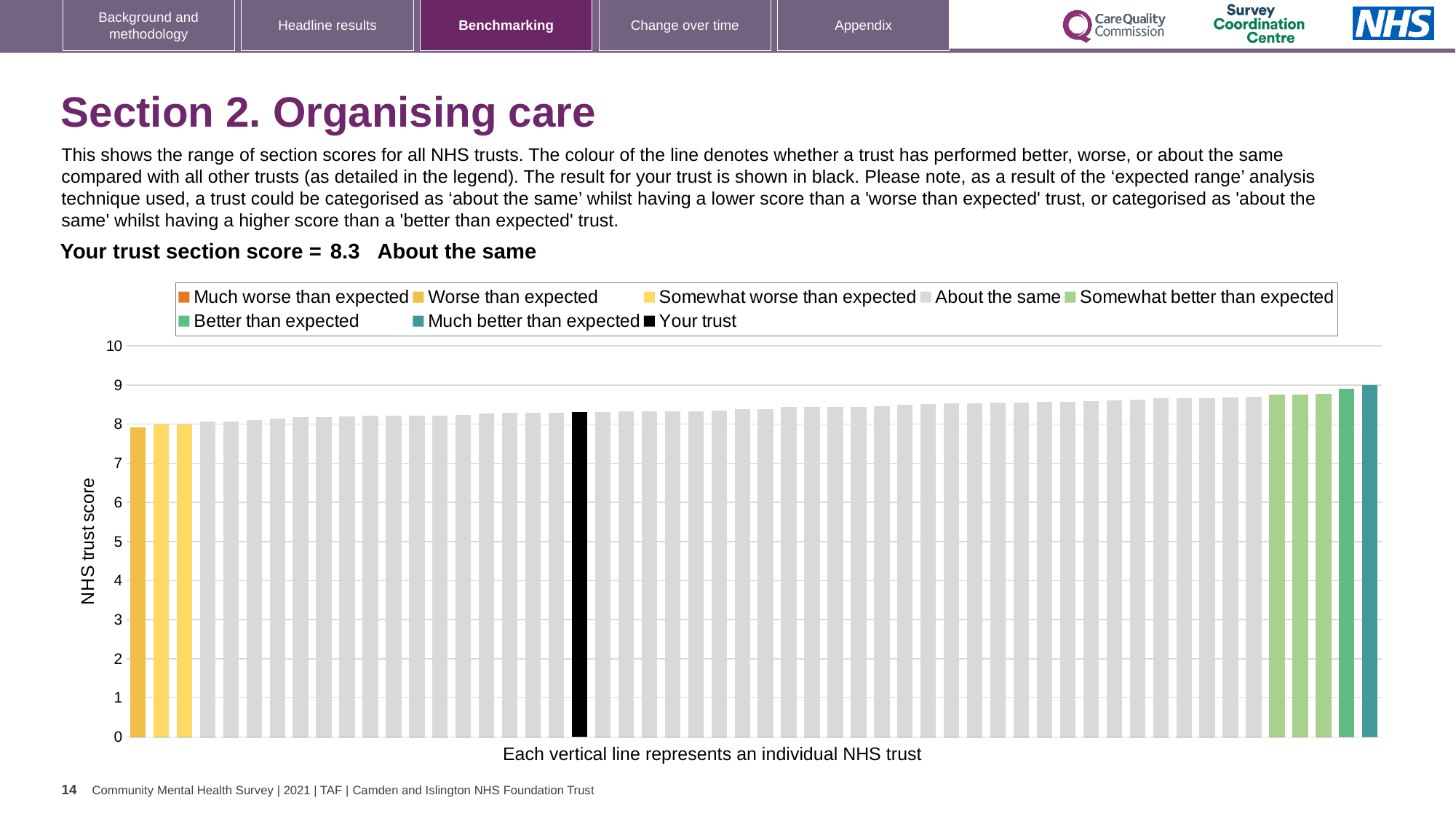
What kind of chart is shown on the slide? bar chart What is the label on the vertical axis? NHS trust score Is the value of the tallest bar greater or less than 8? greater Is the value of the shortest bar greater or less than 9? less Which category is your trust placed in for this section? About the same Which legend category does the tallest bar on the right belong to? Much better than expected Is the value of the black 'Your trust' bar greater or less than 5? greater Do the bar values rise or fall from left to right along the x axis? rise What is your trust's section score for Organising care? 8.3 How many entries does the chart legend list? 8 What colour is the bar representing your trust? black